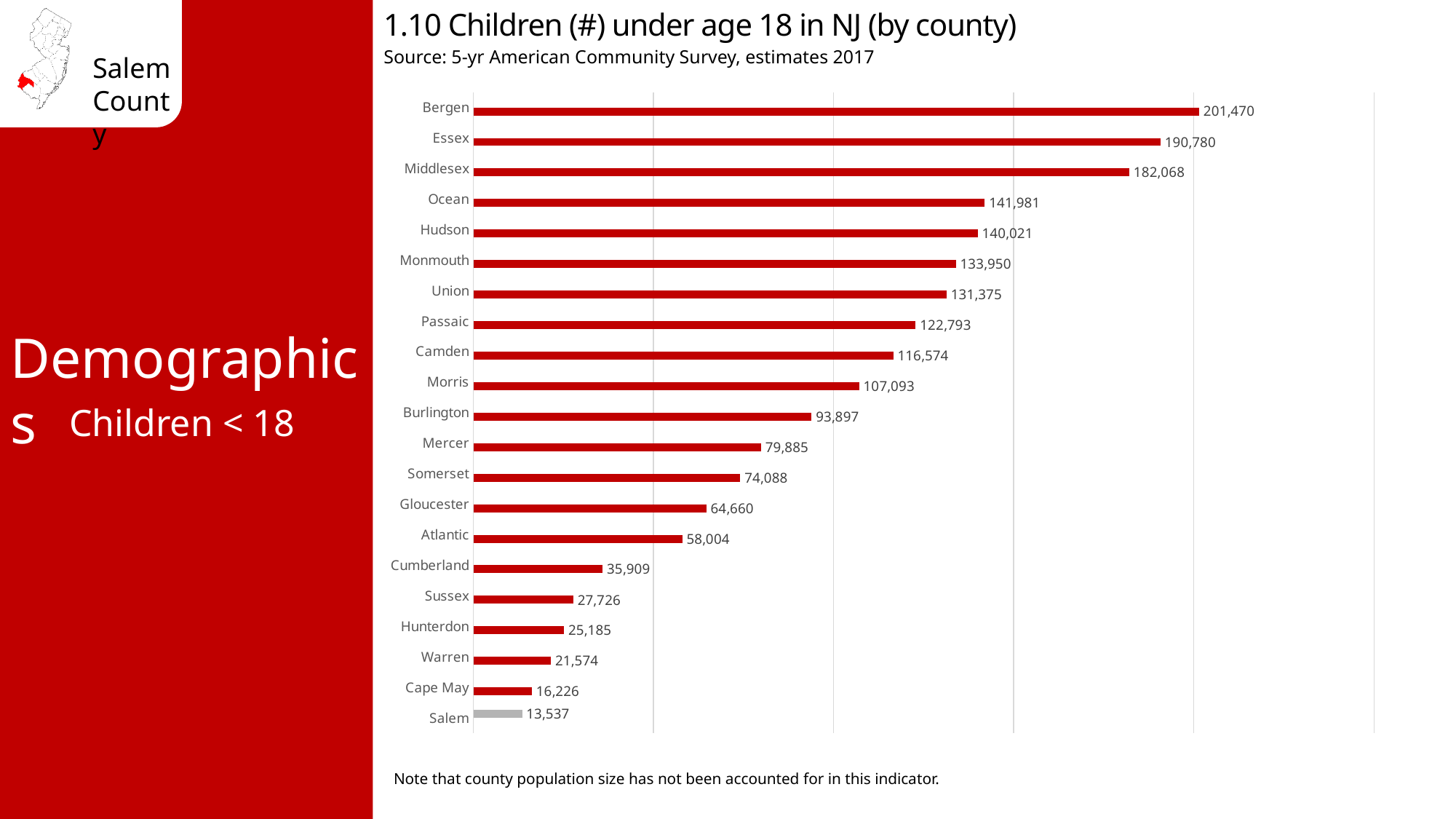
What is the number of children under age 18 in Gloucester county? 64,660 What is the source of the data shown in the chart? 5-yr American Community Survey, estimates 2017 What is the number of children under age 18 in Bergen county? 201,470 Which county has the lowest number of children under age 18? Salem What is the number of children under age 18 in Salem county? 13,537 Which county's bar is shown in a different colour (grey) from the others? Salem What is the difference between the number of children under 18 in Bergen and Essex counties? 10,690 How many counties are shown in the chart? 21 What is the difference between the number of children under 18 in Cape May and Salem counties? 2,689 What type of chart is used on this slide? Bar chart Which county has more children under age 18, Camden or Morris? Camden Which county has the highest number of children under age 18? Bergen